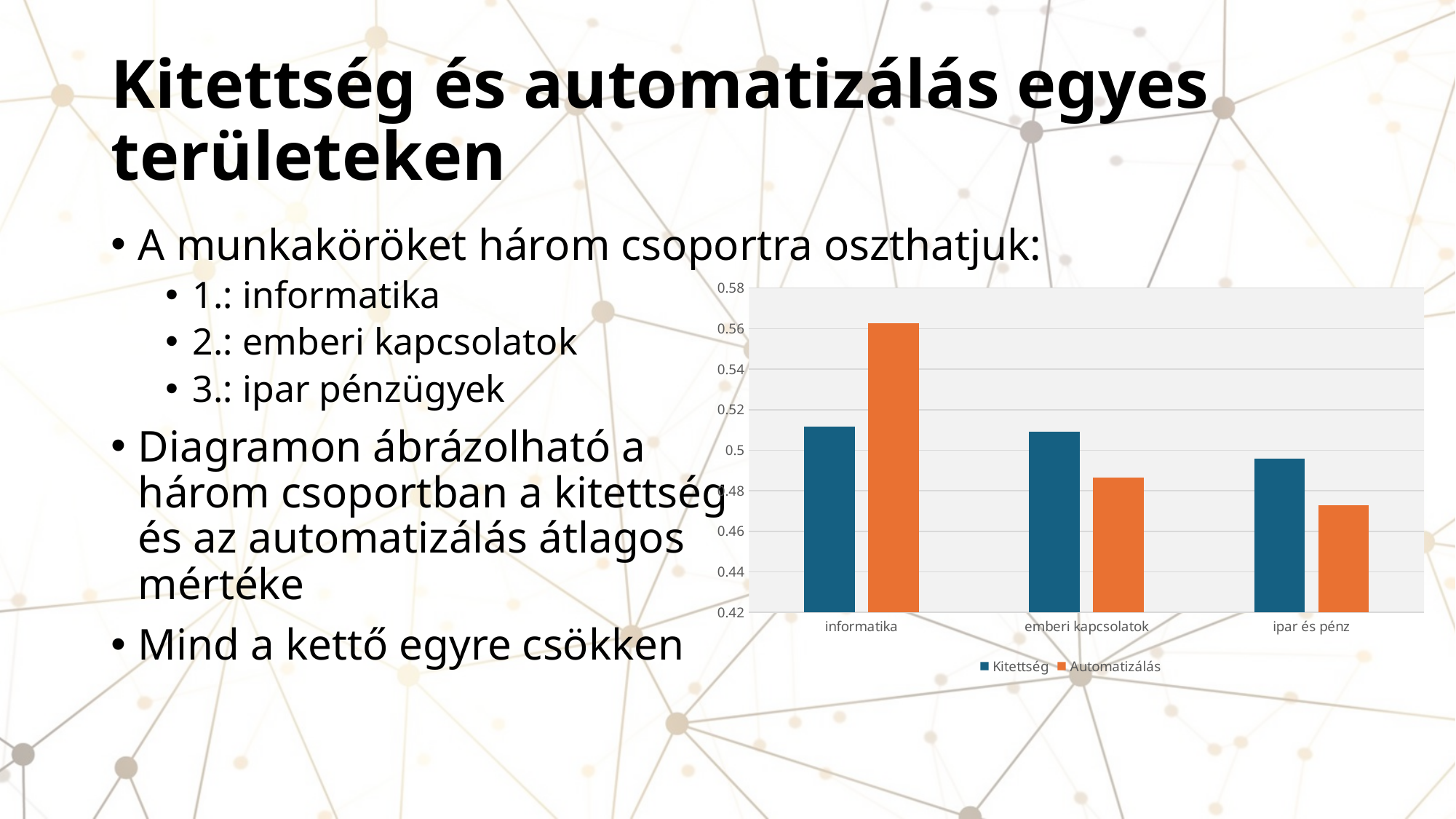
Is the Automatizálás value for informatika greater or less than 0.54? greater How many categories are shown on the x axis of the chart? 3 Is the Automatizálás value for emberi kapcsolatok greater or less than 0.5? less For ipar és pénz, which series has the larger value, Kitettség or Automatizálás? Kitettség What kind of chart is shown on the slide? bar chart Which category has the lowest Automatizálás value? ipar és pénz How many series does the chart's legend list? 2 Which category has the highest Automatizálás value? informatika Is the Kitettség value for informatika greater or less than 0.5? greater Do the Automatizálás values rise or fall from informatika to ipar és pénz? fall For informatika, which series has the larger value, Kitettség or Automatizálás? Automatizálás Which category has the lowest Kitettség value? ipar és pénz